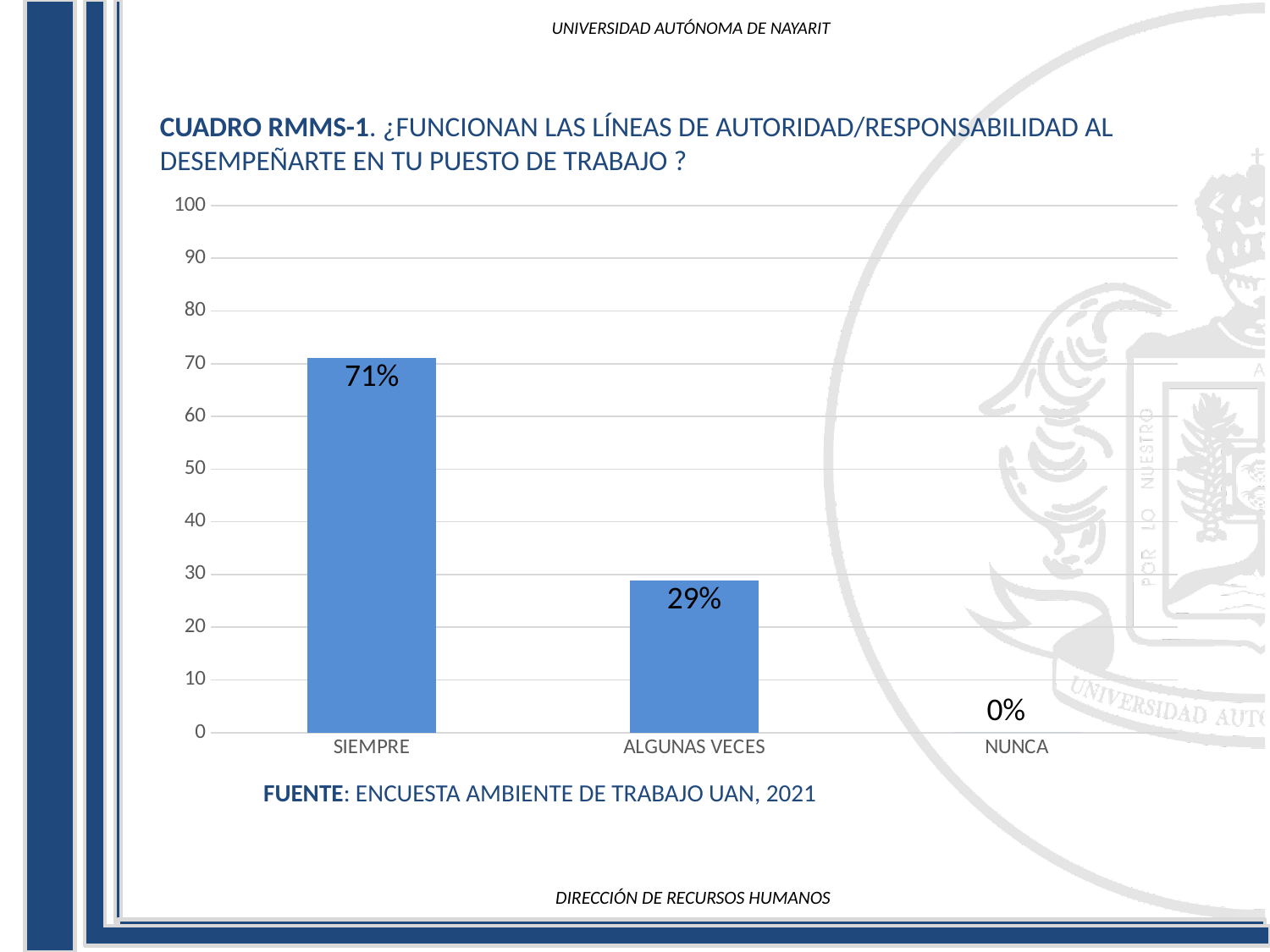
Which category has the lowest value? NUNCA Do the values rise or fall from left to right along the x axis? fall What kind of chart is shown on the slide? bar chart Which category has the highest value? SIEMPRE What is the value for SIEMPRE? 71% What is the difference between the values for SIEMPRE and ALGUNAS VECES? 42% What source is cited below the chart? ENCUESTA AMBIENTE DE TRABAJO UAN, 2021 What is the value for ALGUNAS VECES? 29% What is the value for NUNCA? 0% Which is larger, the value for SIEMPRE or the value for ALGUNAS VECES? SIEMPRE Is the value for ALGUNAS VECES greater or less than 50? less How many categories are shown on the x axis? 3